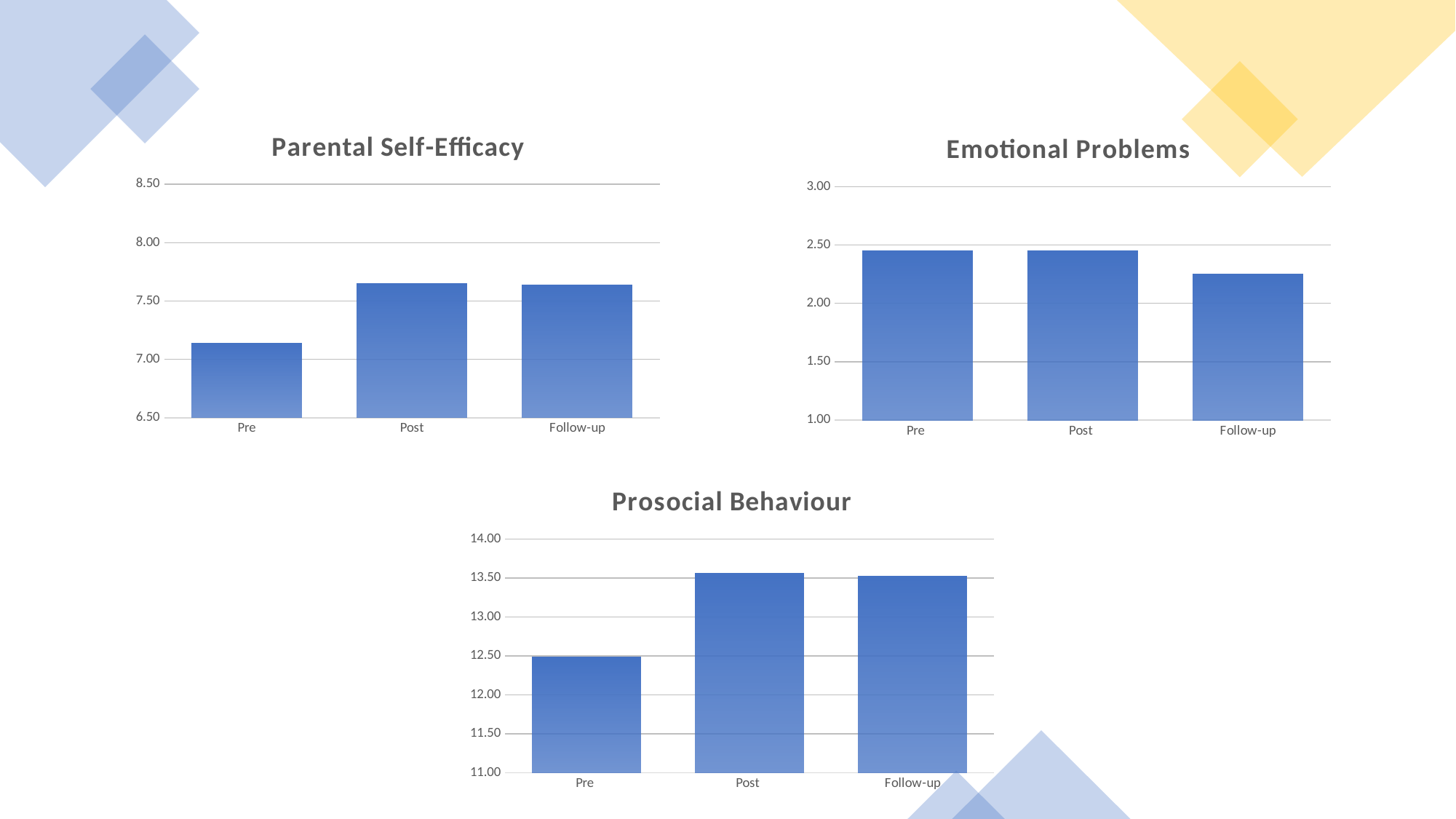
In the Prosocial Behaviour chart, which category has the lowest value? Pre In the Prosocial Behaviour chart, is the value for Post greater or less than 13.00? greater In the Emotional Problems chart, which is larger, the value for Pre or the value for Follow-up? Pre In the Parental Self-Efficacy chart, how many categories are shown on the x axis? 3 In the Parental Self-Efficacy chart, is the value for Pre greater or less than 7.50? less In the Parental Self-Efficacy chart, which category has the lowest value? Pre In the Emotional Problems chart, which category has the lowest value? Follow-up What kind of chart is the Parental Self-Efficacy chart? bar chart In the Parental Self-Efficacy chart, is the value for Post greater or less than 7.50? greater What is the title of the chart at the bottom of the slide? Prosocial Behaviour In the Parental Self-Efficacy chart, which is larger, the value for Pre or the value for Post? Post